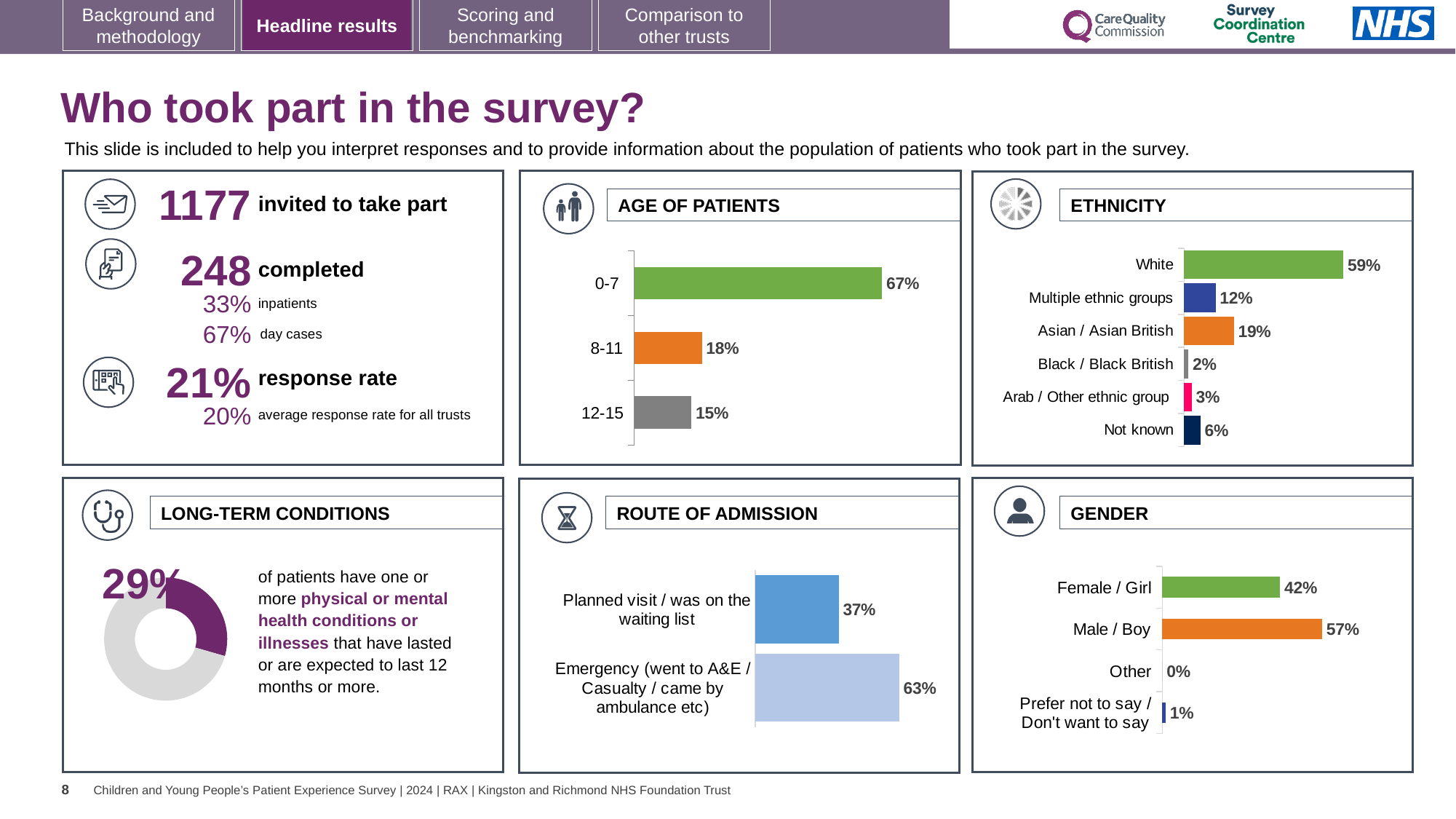
In the ROUTE OF ADMISSION chart, what is the difference between the Emergency and Planned visit percentages? 26 percentage points In the ROUTE OF ADMISSION chart, what percentage of patients came via Emergency (went to A&E / Casualty / came by ambulance etc)? 63% In the ETHNICITY chart, which category has the highest percentage? White In the ETHNICITY chart, how many ethnicity categories are shown? 6 In the AGE OF PATIENTS chart, which age group has the lowest percentage? 12-15 In the ETHNICITY chart, which is larger: Multiple ethnic groups or Not known? Multiple ethnic groups In the AGE OF PATIENTS chart, what is the difference between the 0-7 and 8-11 percentages? 49 percentage points What type of chart is used in the LONG-TERM CONDITIONS panel? Doughnut chart In the GENDER chart, which category has the lowest percentage? Other In the ETHNICITY chart, what percentage of patients were Asian / Asian British? 19% In the AGE OF PATIENTS chart, what percentage of patients were aged 0-7? 67% In the GENDER chart, what percentage of patients were Male / Boy? 57%